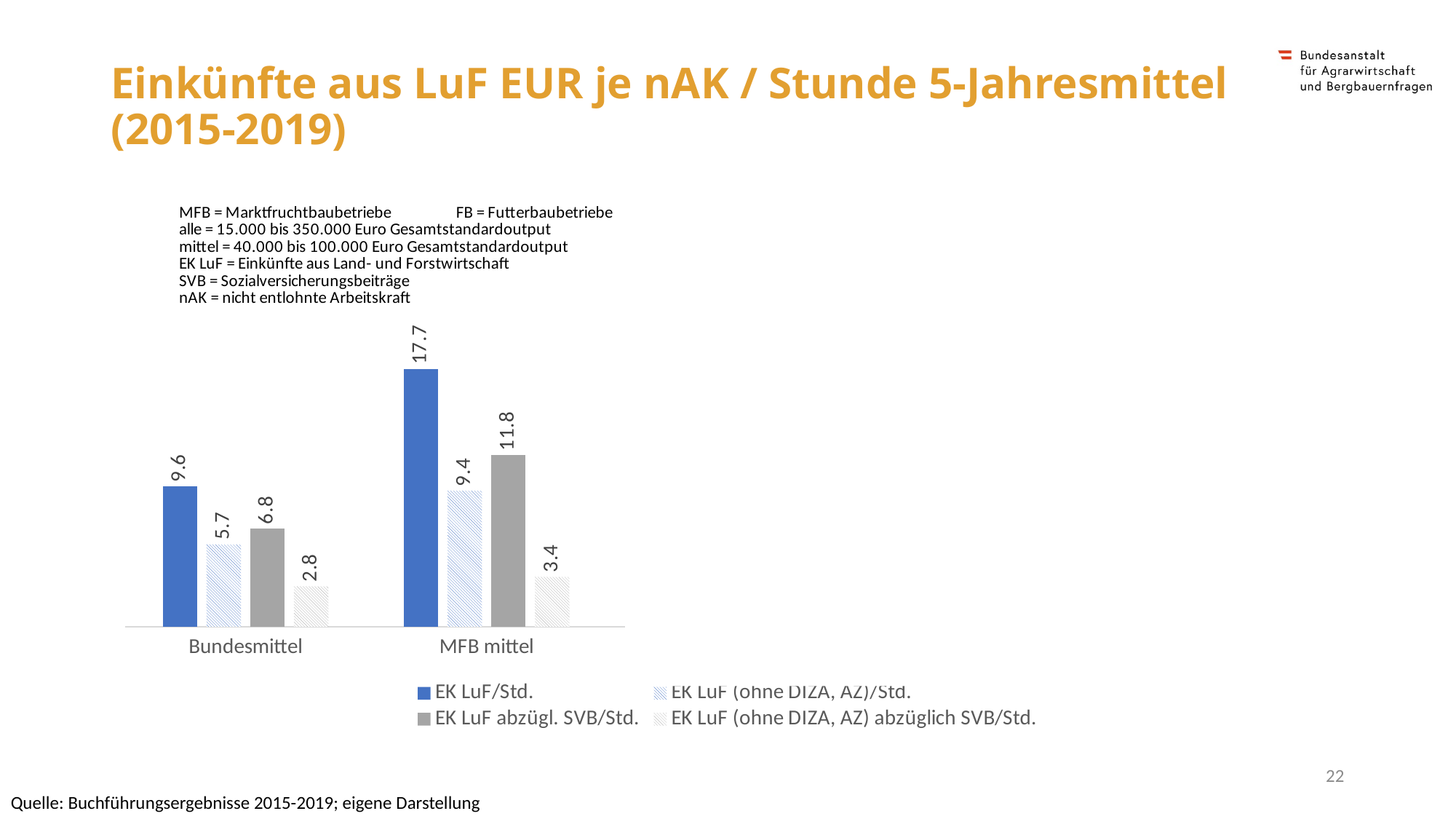
How many series does the legend list? 4 What is the value of EK LuF abzügl. SVB/Std. for Bundesmittel? 6.8 What is the value of EK LuF (ohne DIZA, AZ)/Std. for MFB mittel? 9.4 Which series has the lowest value for MFB mittel? EK LuF (ohne DIZA, AZ) abzüglich SVB/Std. What is the value of EK LuF/Std. for MFB mittel? 17.7 What is the difference between EK LuF abzügl. SVB/Std. for MFB mittel and for Bundesmittel? 5.0 Which is larger: EK LuF abzügl. SVB/Std. for Bundesmittel or EK LuF (ohne DIZA, AZ)/Std. for Bundesmittel? EK LuF abzügl. SVB/Std. What is the difference between EK LuF/Std. for MFB mittel and for Bundesmittel? 8.1 How many categories are shown on the x axis? 2 Which category has the highest EK LuF/Std. value? MFB mittel What is the value of EK LuF (ohne DIZA, AZ) abzüglich SVB/Std. for Bundesmittel? 2.8 What kind of chart is shown on the slide? Bar chart